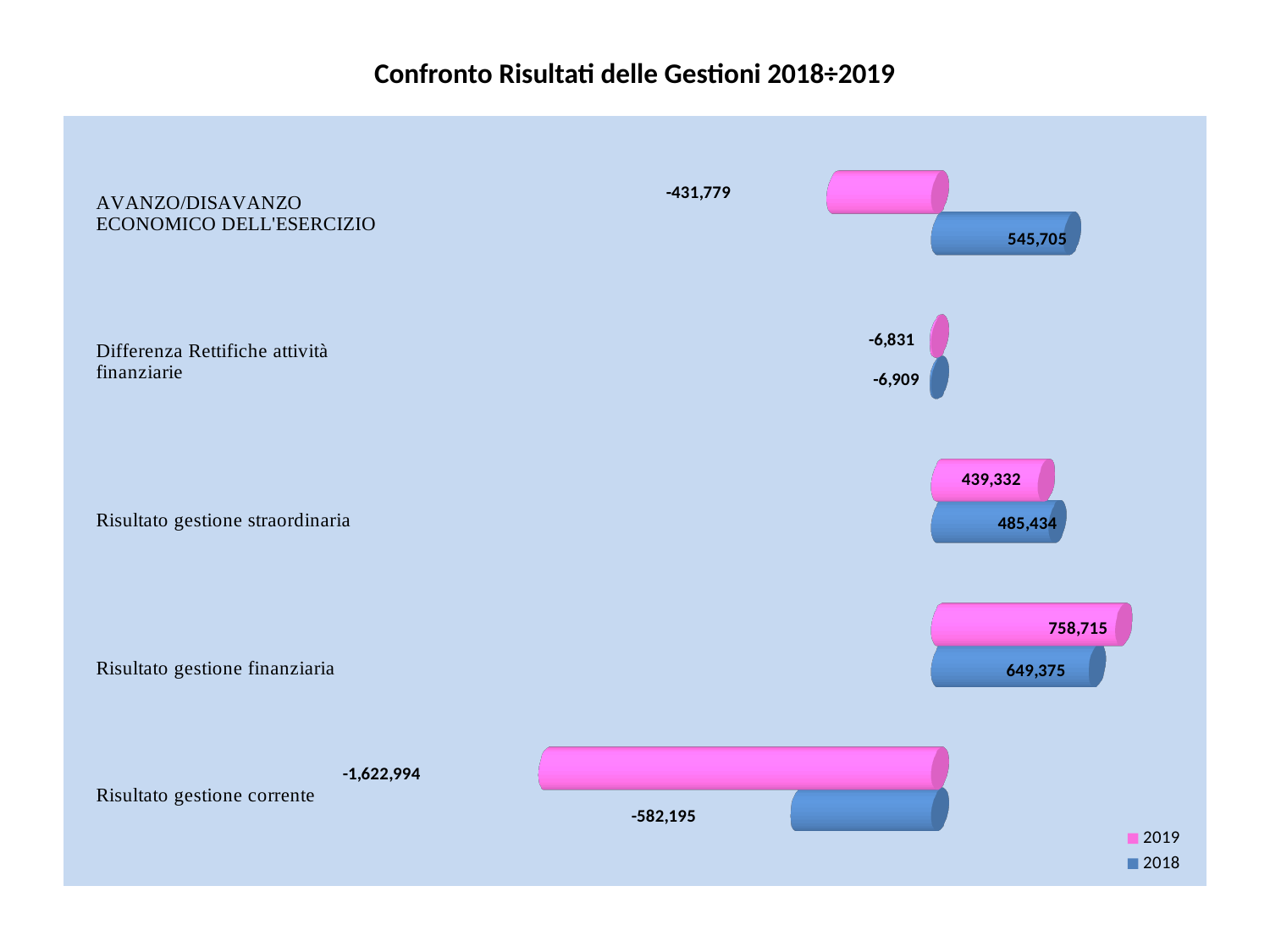
What is the 2018 value for AVANZO/DISAVANZO ECONOMICO DELL'ESERCIZIO? 545,705 What is the 2019 value for Risultato gestione corrente? -1,622,994 Which category has the lowest 2018 value? Risultato gestione corrente What is the difference between the 2018 and 2019 values for Risultato gestione straordinaria? 46,102 How many series does the legend list? 2 What is the difference between the 2019 and 2018 values for Risultato gestione finanziaria? 109,340 For Risultato gestione straordinaria, which year has the larger value, 2018 or 2019? 2018 What is the 2018 value for Differenza Rettifiche attività finanziarie? -6,909 What is the 2019 value for Risultato gestione finanziaria? 758,715 Which category has the highest 2019 value? Risultato gestione finanziaria What type of chart is shown on the slide? Bar chart How many categories are shown in the chart? 5